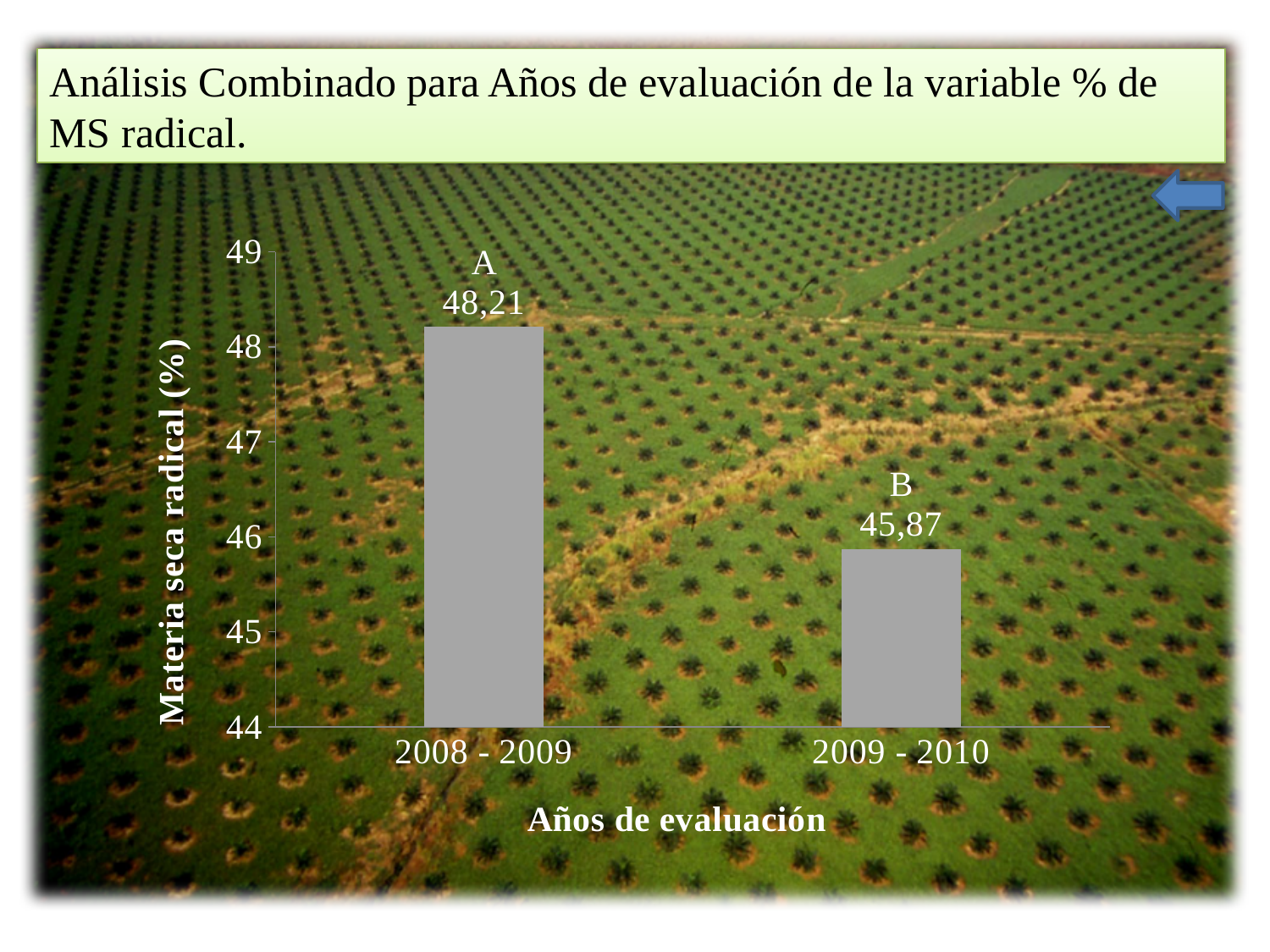
What is the label of the y axis? Materia seca radical (%) Do the values rise or fall from 2008 - 2009 to 2009 - 2010? fall Which evaluation year has the highest value? 2008 - 2009 What is the difference between the values for 2008 - 2009 and 2009 - 2010? 2,34 Which is larger, the value for 2008 - 2009 or for 2009 - 2010? 2008 - 2009 Which evaluation year has the lowest value? 2009 - 2010 Is the value for 2009 - 2010 greater or less than 46? less What kind of chart is shown on the slide? bar chart What is the value for 2009 - 2010? 45,87 What is the value for 2008 - 2009? 48,21 How many categories are shown on the x axis? 2 Is the value for 2008 - 2009 greater or less than 48? greater